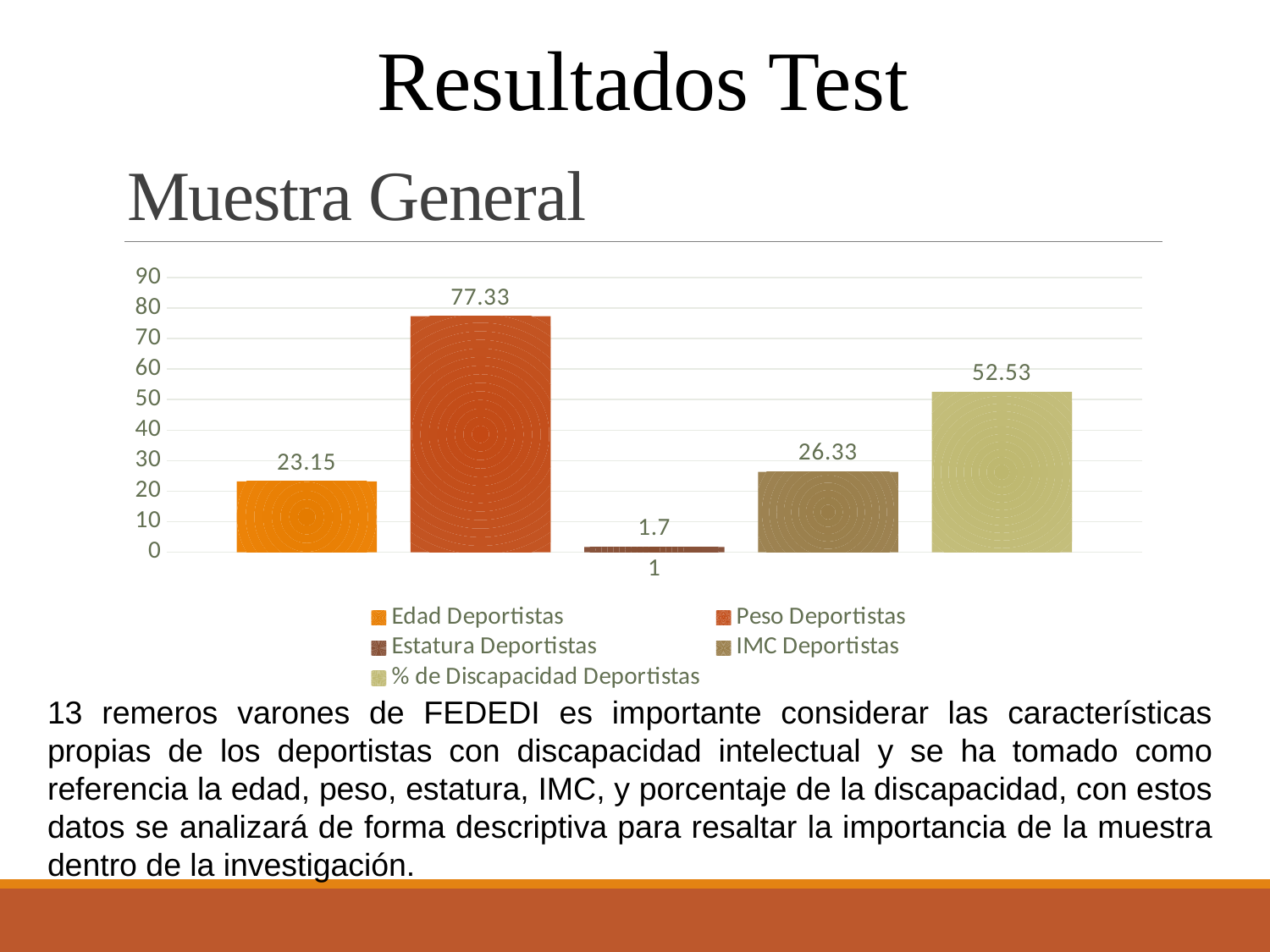
How many series does the legend list? 5 Which series has the lowest value? Estatura Deportistas What is the title shown above the chart? Muestra General What is the value for Estatura Deportistas? 1.7 What is the value for % de Discapacidad Deportistas? 52.53 What is the difference between Peso Deportistas and % de Discapacidad Deportistas? 24.8 What kind of chart is shown on the slide? Bar chart Which series has the highest value? Peso Deportistas Which is larger, IMC Deportistas or Edad Deportistas? IMC Deportistas What is the value for IMC Deportistas? 26.33 What is the value for Peso Deportistas? 77.33 What is the value for Edad Deportistas? 23.15